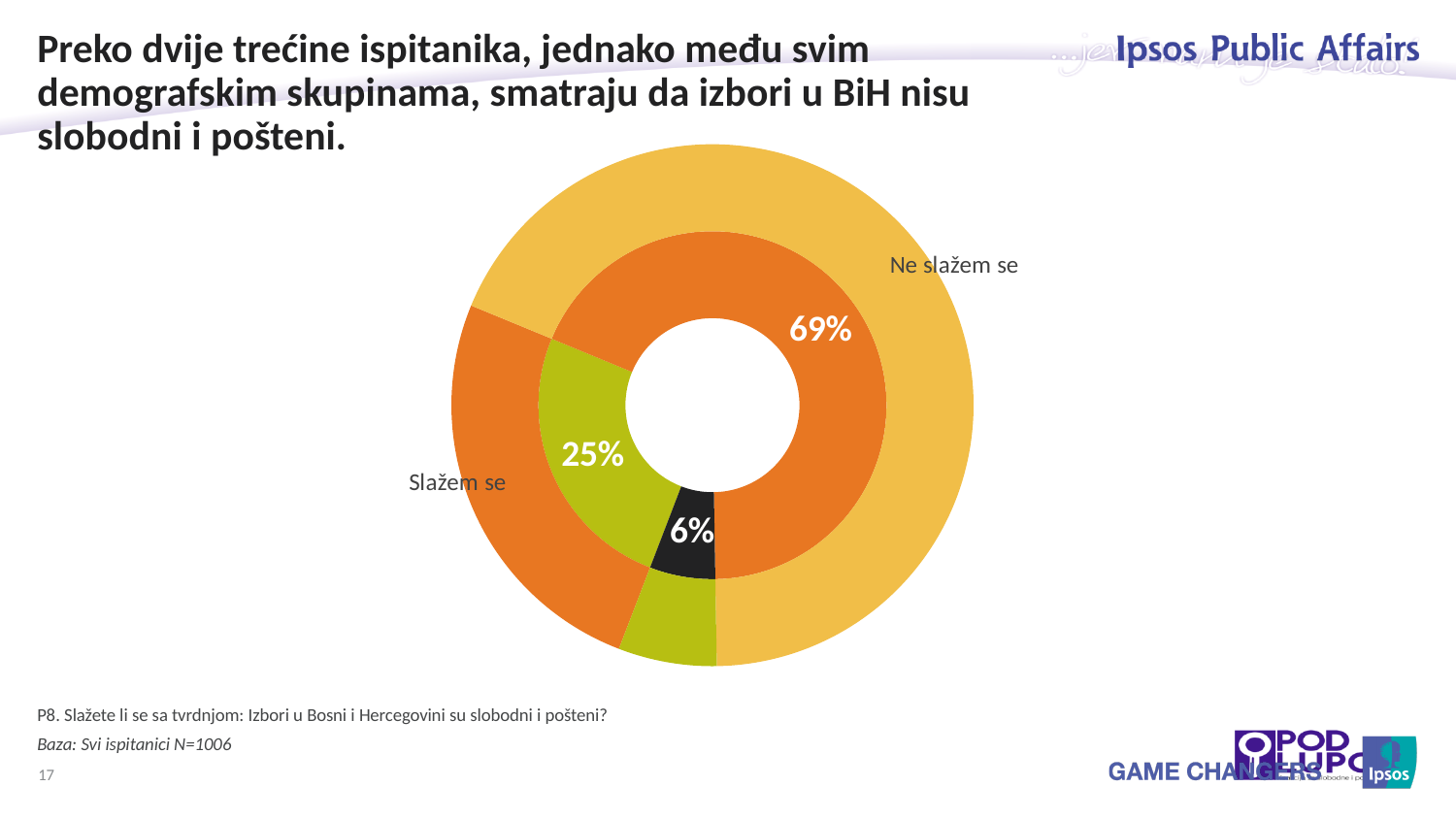
What is the base (N) of respondents stated on the slide? N=1006 What percentage of respondents answered "Ne slažem se"? 69% What percentage of respondents answered "Slažem se"? 25% Which response has the largest share on the chart? Ne slažem se What is the smallest percentage shown on the chart? 6% What share of the chart does the "Ne slažem se" slice represent? 69% Which is larger, the share for "Slažem se" or the share for "Ne slažem se"? Ne slažem se What kind of chart is shown on the slide? Doughnut chart How many percentage values are labelled on the chart? 3 What do the three labelled percentages on the chart add up to? 100% What survey question (P8) does the chart refer to? Slažete li se sa tvrdnjom: Izbori u Bosni i Hercegovini su slobodni i pošteni? By how many percentage points does "Ne slažem se" exceed "Slažem se"? 44 percentage points